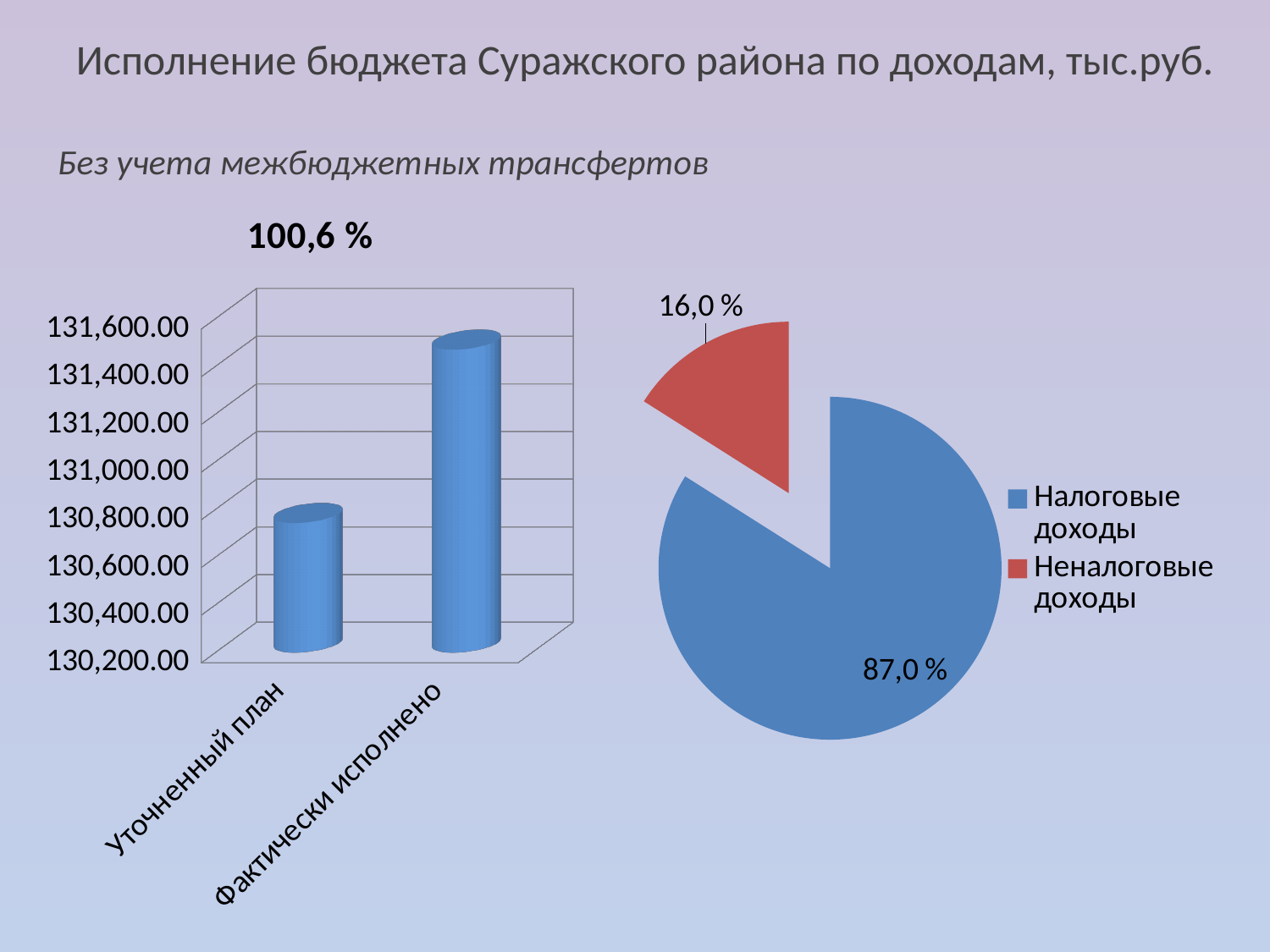
In the left bar chart, is the value for Уточненный план greater or less than 131,000.00? less In the right pie chart, what share is shown for Неналоговые доходы? 16,0 % What kind of chart is the right chart on the slide? pie chart In the left bar chart, which category has the lowest value? Уточненный план In the right pie chart, what share is shown for Налоговые доходы? 87,0 % In the left bar chart, is the value for Уточненный план greater or less than 130,600.00? greater In the left bar chart, which category has the highest value? Фактически исполнено In the right pie chart, which slice is larger, Налоговые доходы or Неналоговые доходы? Налоговые доходы In the right pie chart, what colour is the Неналоговые доходы slice? red What kind of chart is the left chart on the slide? bar chart In the left bar chart, is the value for Фактически исполнено greater or less than 131,200.00? greater In the left bar chart, how many categories are shown? 2